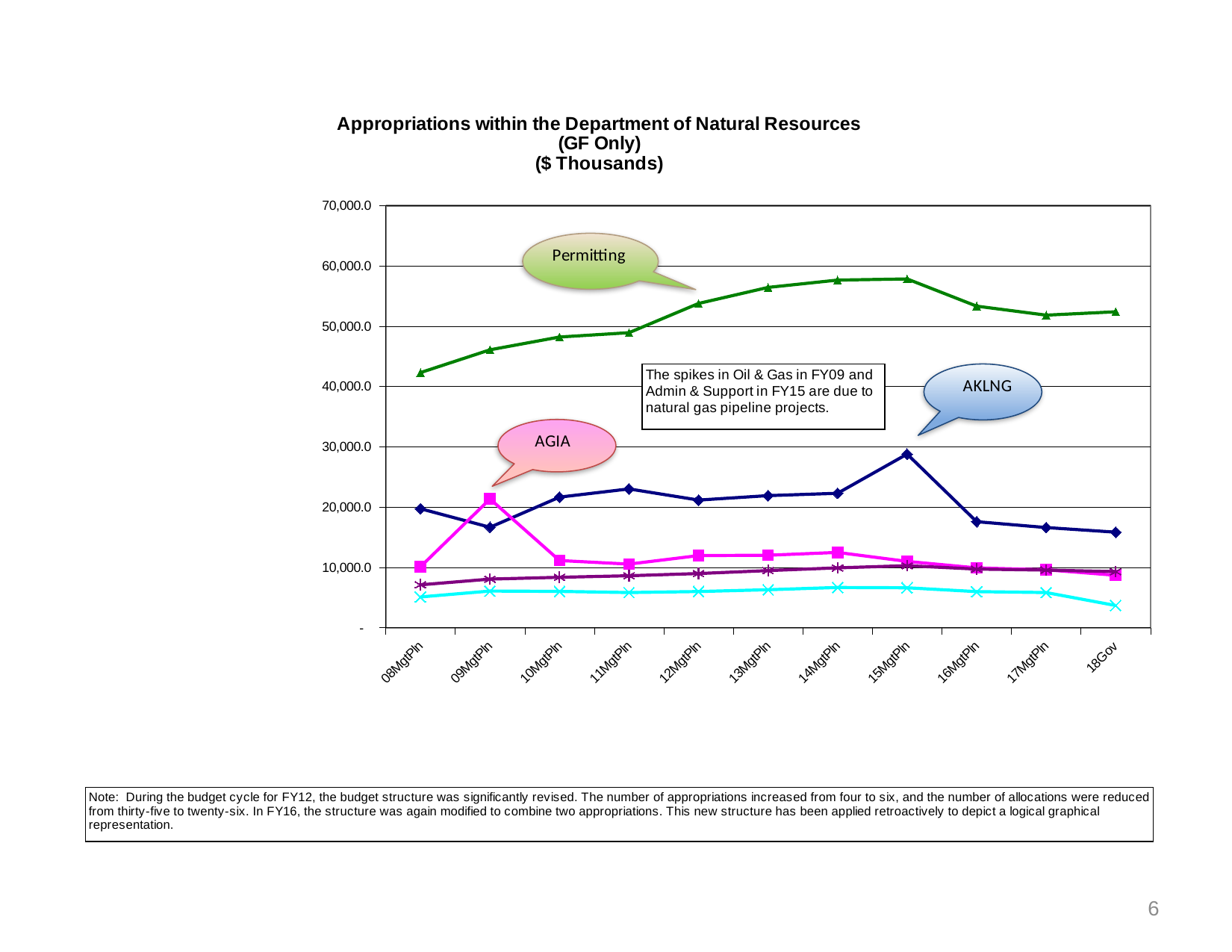
How many lines are plotted on the chart? 5 Is the value of the green line labelled Permitting at 15MgtPln greater or less than 60,000.0? less Is the value of the dark blue line at its AKLNG spike at 15MgtPln greater or less than 30,000.0? less Is the value of the green line labelled Permitting at 08MgtPln greater or less than 40,000.0? greater What is the title of the chart? Appropriations within the Department of Natural Resources (GF Only) ($ Thousands) What kind of chart is shown on the slide? line chart How many categories are shown along the x axis of the chart? 11 At which x-axis category is the green line labelled Permitting at its lowest? 08MgtPln At 09MgtPln, which is larger: the pink line (AGIA spike) or the dark blue line? the pink line Does the green line labelled Permitting rise or fall from 08MgtPln to 15MgtPln? rise